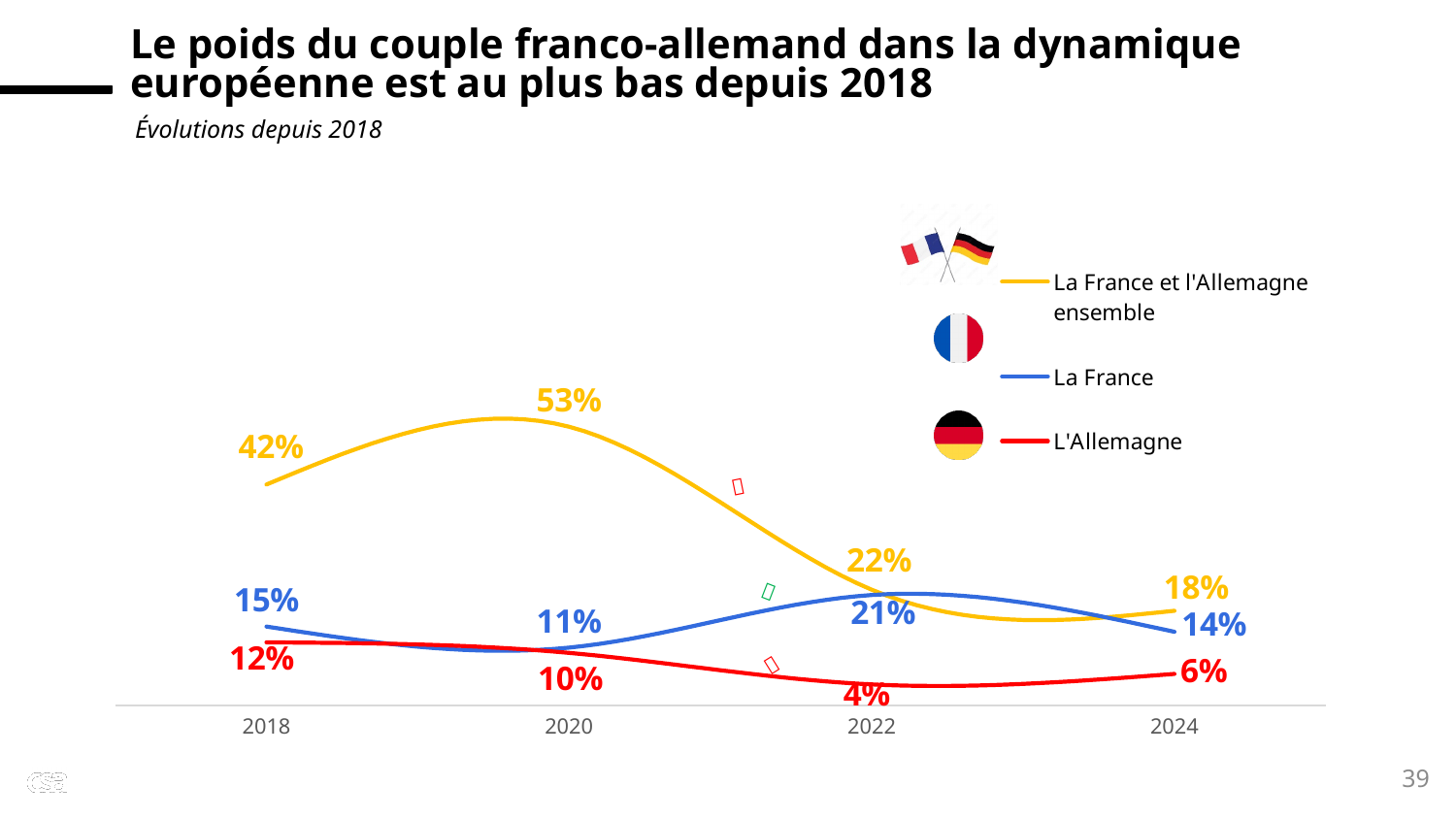
In which year is the value for "L'Allemagne" lowest? 2022 What is the value for "La France et l'Allemagne ensemble" in 2024? 18% In which year does "La France et l'Allemagne ensemble" reach its highest value? 2020 Does the value for "La France et l'Allemagne ensemble" rise or fall between 2020 and 2024? Fall What is the value for "La France et l'Allemagne ensemble" in 2020? 53% What is the difference between the 2018 and 2024 values for "La France et l'Allemagne ensemble"? 24 percentage points What kind of chart is shown on the slide? Line chart What is the value for "La France" in 2022? 21% Which is larger in 2022: the value for "La France" or the value for "L'Allemagne"? La France How many series does the legend list? 3 How many years are shown on the x axis? 4 What is the value for "L'Allemagne" in 2024? 6%